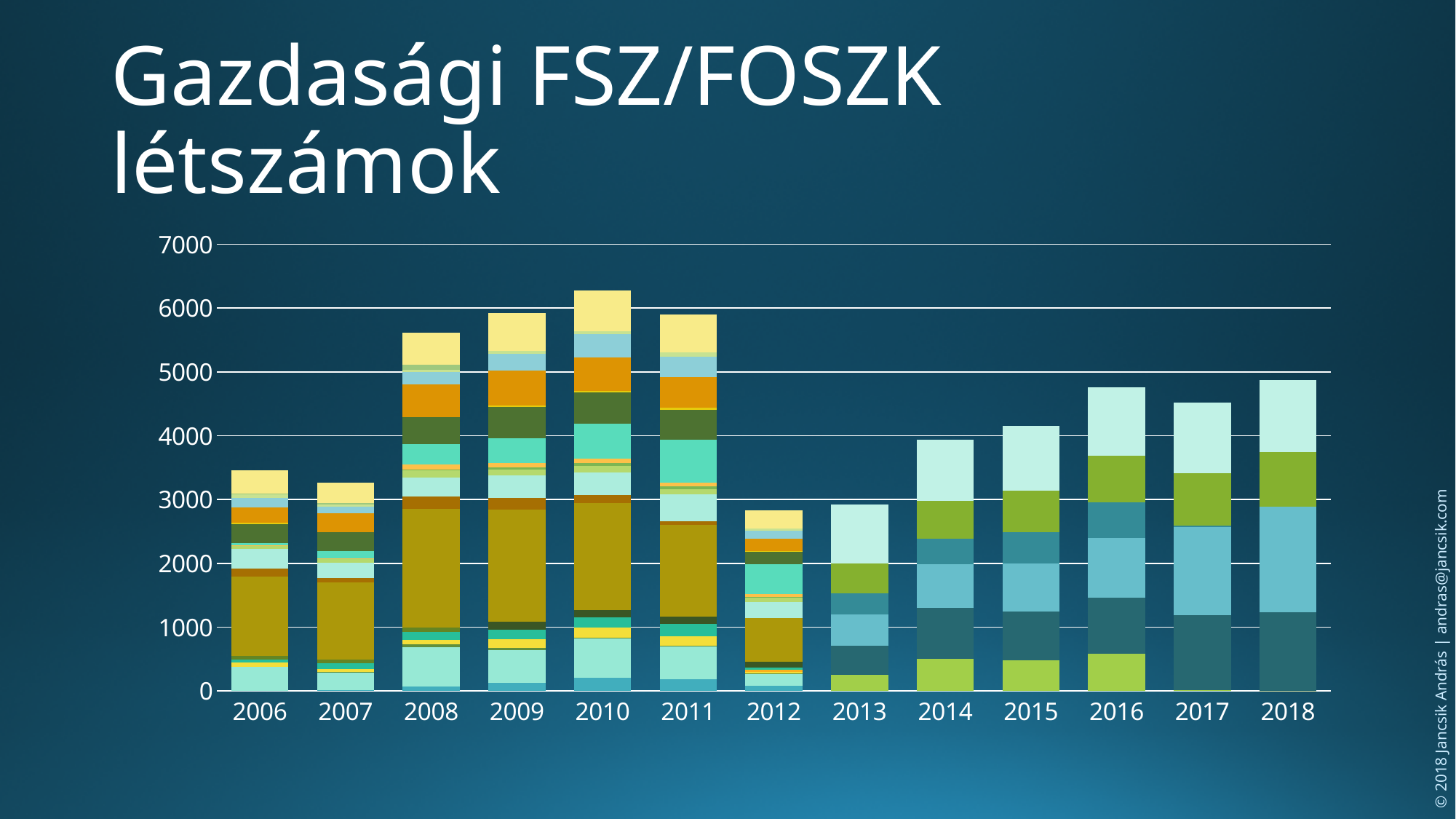
Do the bar totals rise or fall from 2007 to 2010? rise Is the total for 2006 greater or less than 3000? greater Is the total for 2017 greater or less than 4000? greater What is the title of the slide containing the chart? Gazdasági FSZ/FOSZK létszámok Is the total for 2018 greater or less than 5000? less Which year has the taller stacked bar, 2010 or 2018? 2010 Which year has the tallest stacked bar? 2010 What kind of chart is shown on the slide? stacked bar chart How many years are shown on the x axis of the chart? 13 Which year has the taller stacked bar, 2013 or 2014? 2014